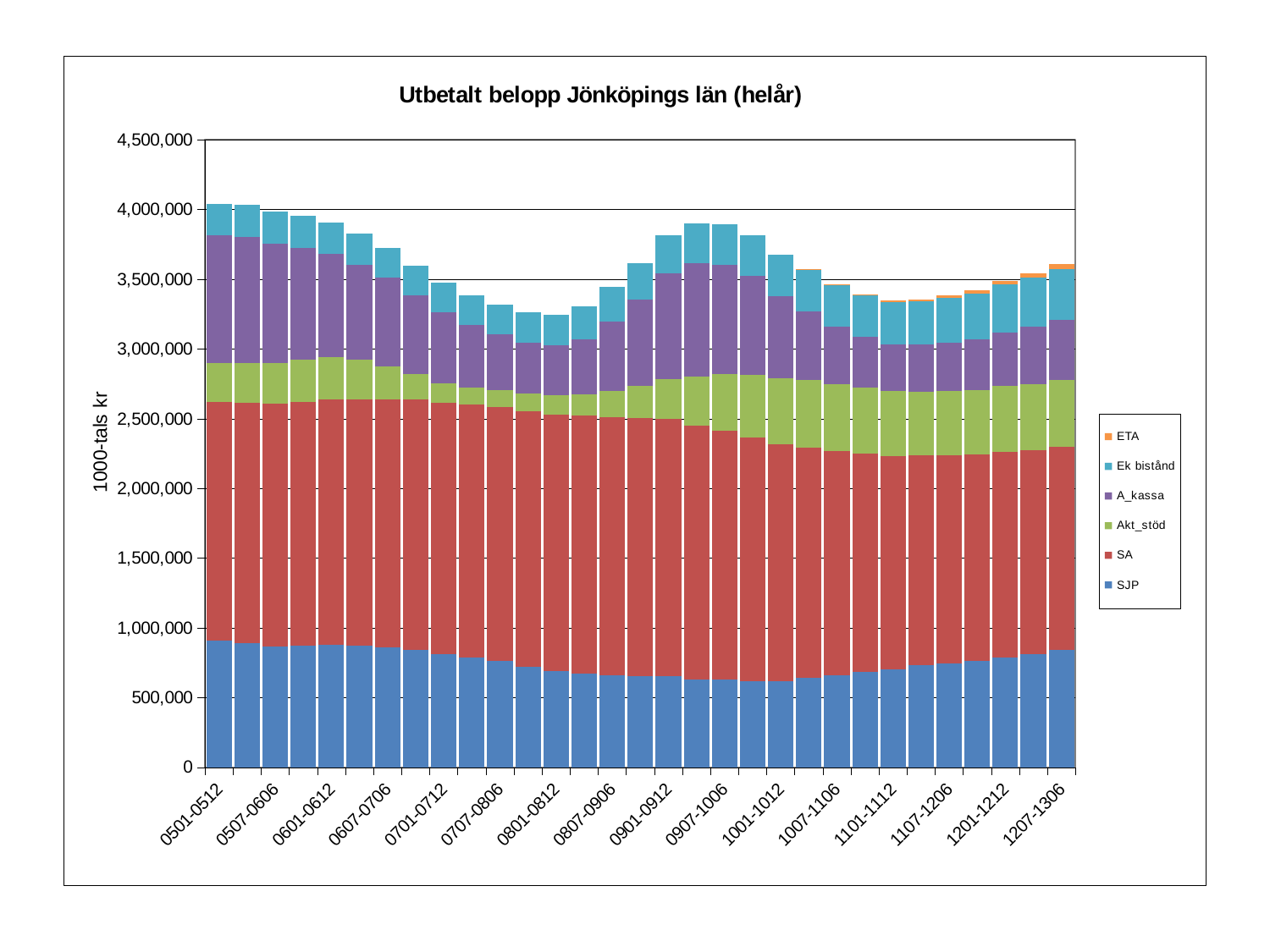
How many series does the legend list? 6 Is the total stacked value for 0801-0812 greater or less than 3,500,000? less Is the SJP value for 0907-1006 greater or less than 500,000? greater Is the SJP value for 0501-0512 greater or less than 1,000,000? less What is the title of the chart? Utbetalt belopp Jönköpings län (helår) Do the total stacked values rise or fall from 0501-0512 to 0801-0812? fall Which has the larger total stacked value, 0907-1006 or 1101-1112? 0907-1006 What is the label on the vertical axis? 1000-tals kr What kind of chart is shown on the slide? Stacked bar chart Which has the larger total stacked value, 0501-0512 or 0801-0812? 0501-0512